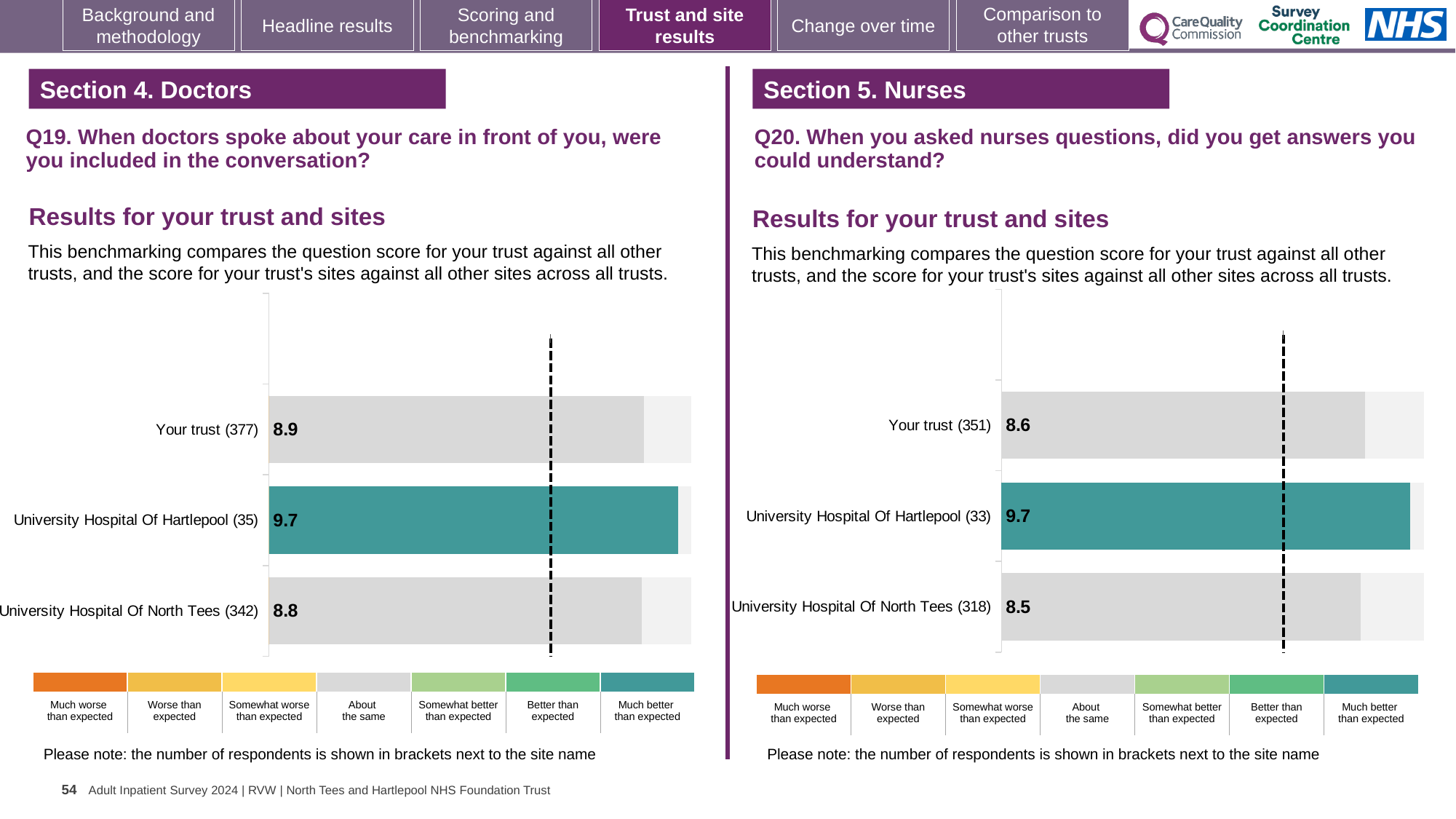
On the Q19 chart (left), what is the score for University Hospital Of North Tees (342)? 8.8 On the Q19 chart (left), which site or trust has the highest score? University Hospital Of Hartlepool (35) On the Q20 chart (right), what is the score for University Hospital Of North Tees (318)? 8.5 What kind of chart is used on the Q20 chart (right)? Bar chart On the Q19 chart (left), how many bars are plotted? 3 On the Q20 chart (right), which site or trust has the lowest score? University Hospital Of North Tees (318) On the Q20 chart (right), what is the score for Your trust (351)? 8.6 On the Q19 chart (left), what is the score for Your trust (377)? 8.9 On the Q19 chart (left), what is the score for University Hospital Of Hartlepool (35)? 9.7 On the Q20 chart (right), what is the difference between the scores for University Hospital Of Hartlepool and Your trust? 1.1 On the Q19 chart (left), what is the difference between the scores for University Hospital Of Hartlepool and University Hospital Of North Tees? 0.9 On the Q20 chart (right), which benchmark category does the colour of the University Hospital Of Hartlepool bar correspond to in the legend? Much better than expected